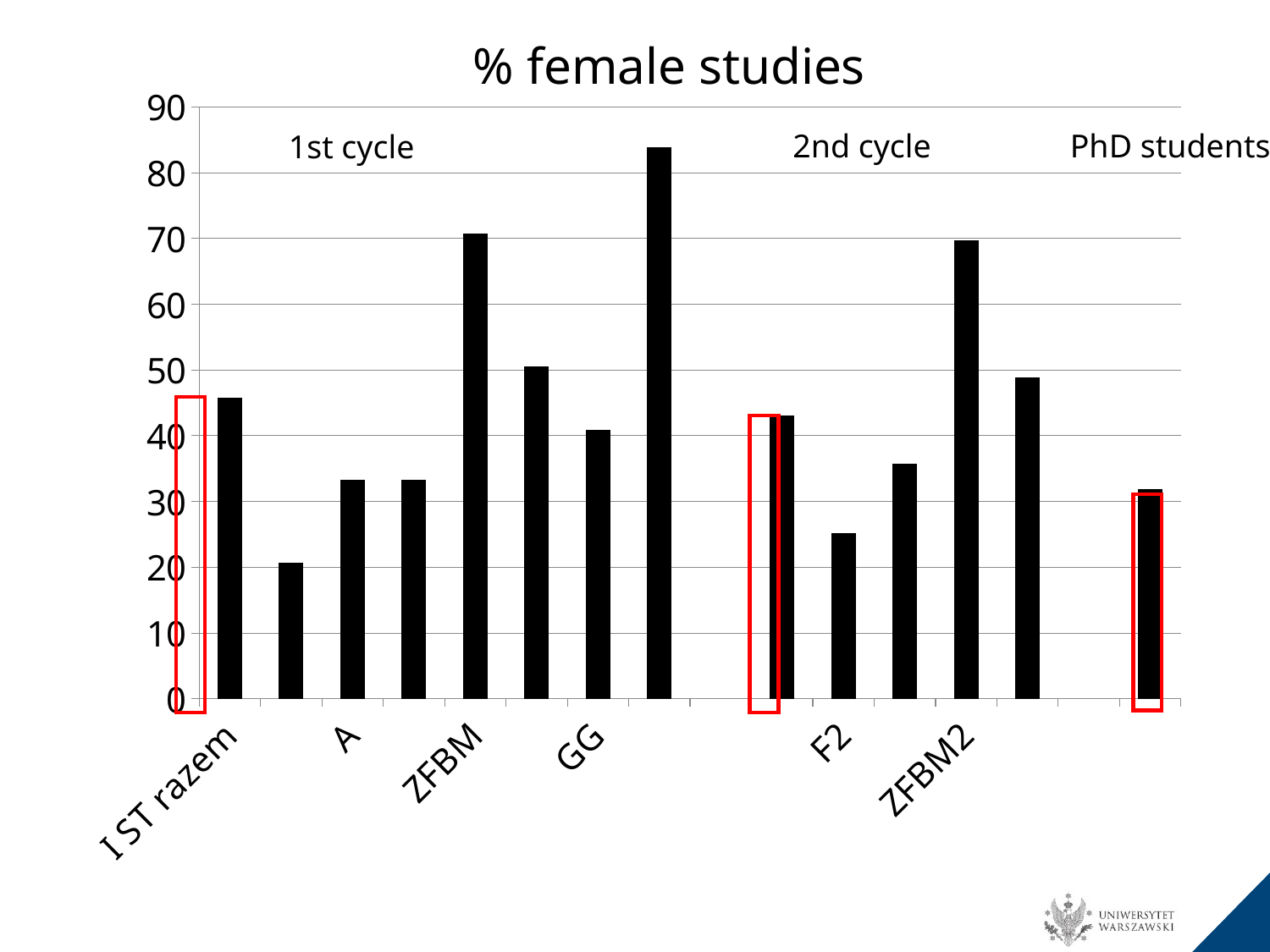
Which has the higher value, A or F2? A Is the value for I ST razem greater or less than 40? greater Is the value for GG greater or less than 50? less Which has the higher value, ZFBM or GG? ZFBM What is the title of the chart? % female studies Is the value for ZFBM greater or less than 60? greater Which of the three groups labelled on the chart contains the tallest bar? 1st cycle What type of chart is shown on the slide? bar chart How many bars are plotted in the chart? 14